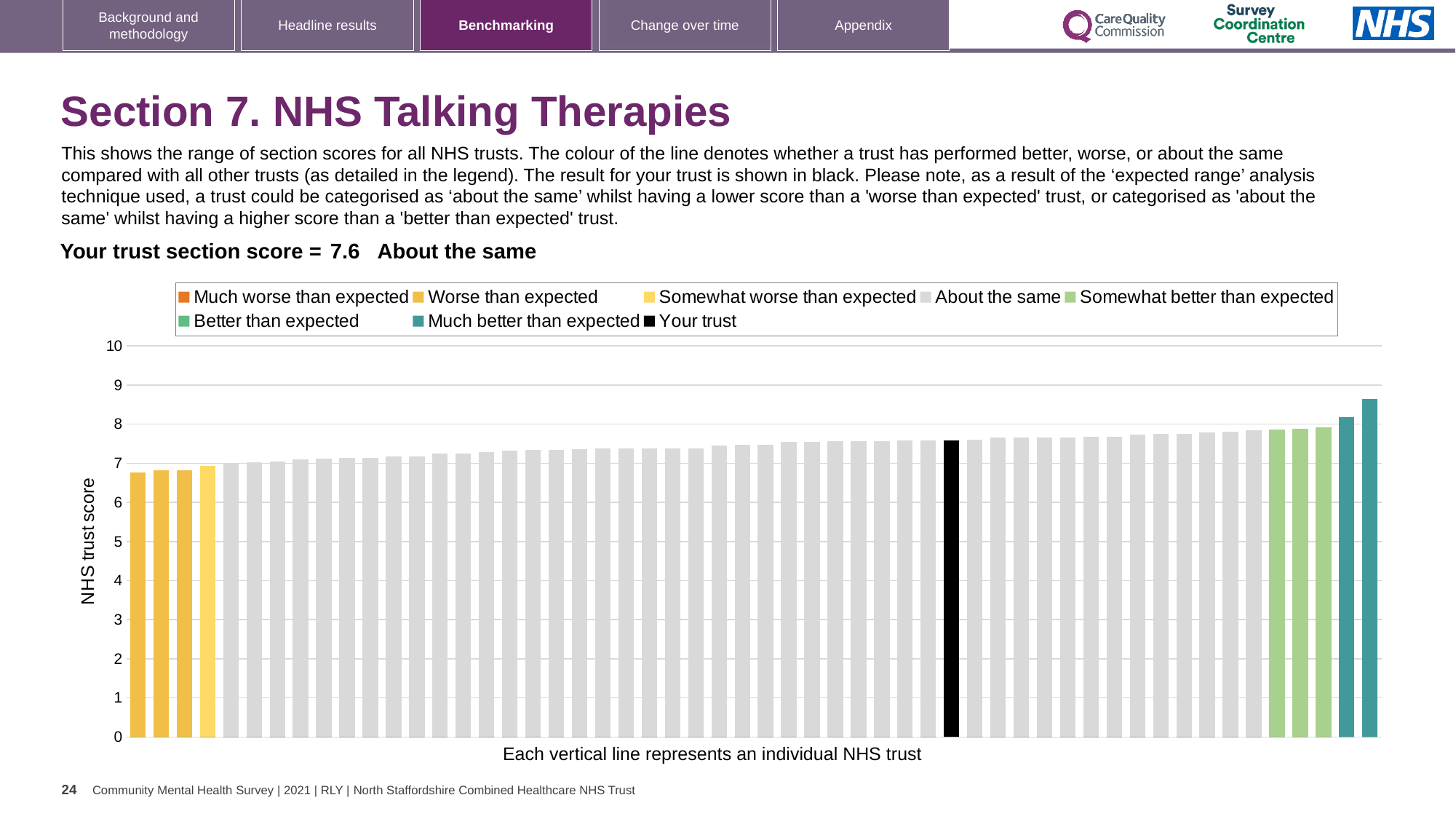
Which category is your trust placed in according to the slide? About the same Is the value of the shortest bar in the chart greater or less than 7? less How many entries does the chart legend list? 8 Is the value for your trust (the black bar) greater or less than 7? greater Is the value of the tallest bar in the chart greater or less than 8? greater Do the bar values rise or fall from left to right across the chart? rise How many bars are coloured as 'Somewhat better than expected' (light green) in the chart? 3 What kind of chart is shown on the slide? bar chart What is the label of the vertical axis of the chart? NHS trust score What is the section score for your trust shown on the slide? 7.6 How many bars are coloured as 'Much better than expected' (teal) in the chart? 2